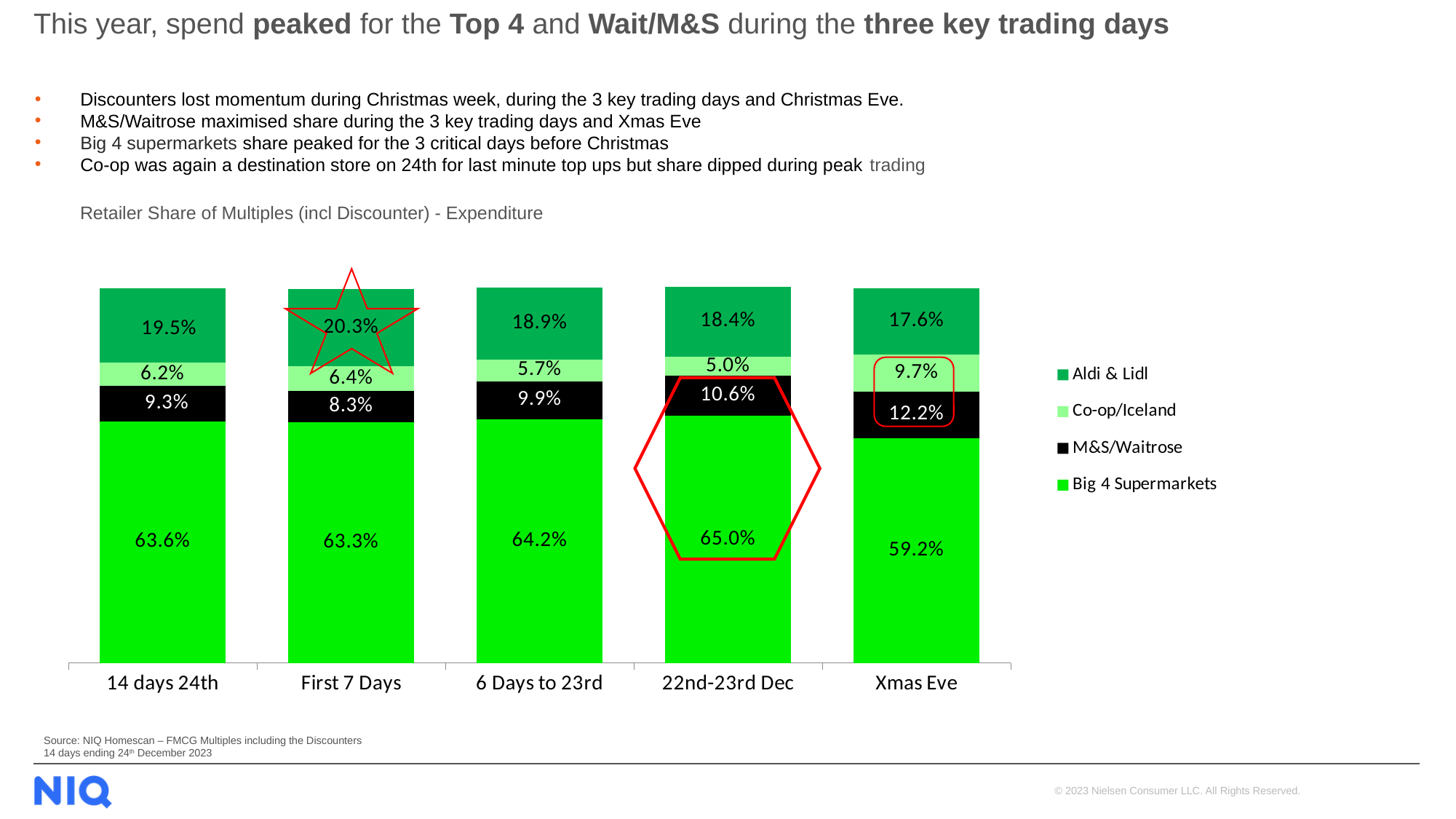
In which period is the Aldi & Lidl share highest? First 7 Days Does the Aldi & Lidl share rise or fall from First 7 Days through to Xmas Eve? Fall What is the Co-op/Iceland share for 6 Days to 23rd? 5.7% What is the Aldi & Lidl share for 14 days 24th? 19.5% In which period is the Big 4 Supermarkets share lowest? Xmas Eve What is the difference between the M&S/Waitrose share on Xmas Eve and for 14 days 24th? 2.9 percentage points Which is larger: the Co-op/Iceland share on Xmas Eve or for 22nd-23rd Dec? Xmas Eve What is the M&S/Waitrose share on Xmas Eve? 12.2% What kind of chart is shown? Stacked bar chart How many series does the legend list? 4 What is the Big 4 Supermarkets share for 22nd-23rd Dec? 65.0% How many periods are shown on the x axis? 5